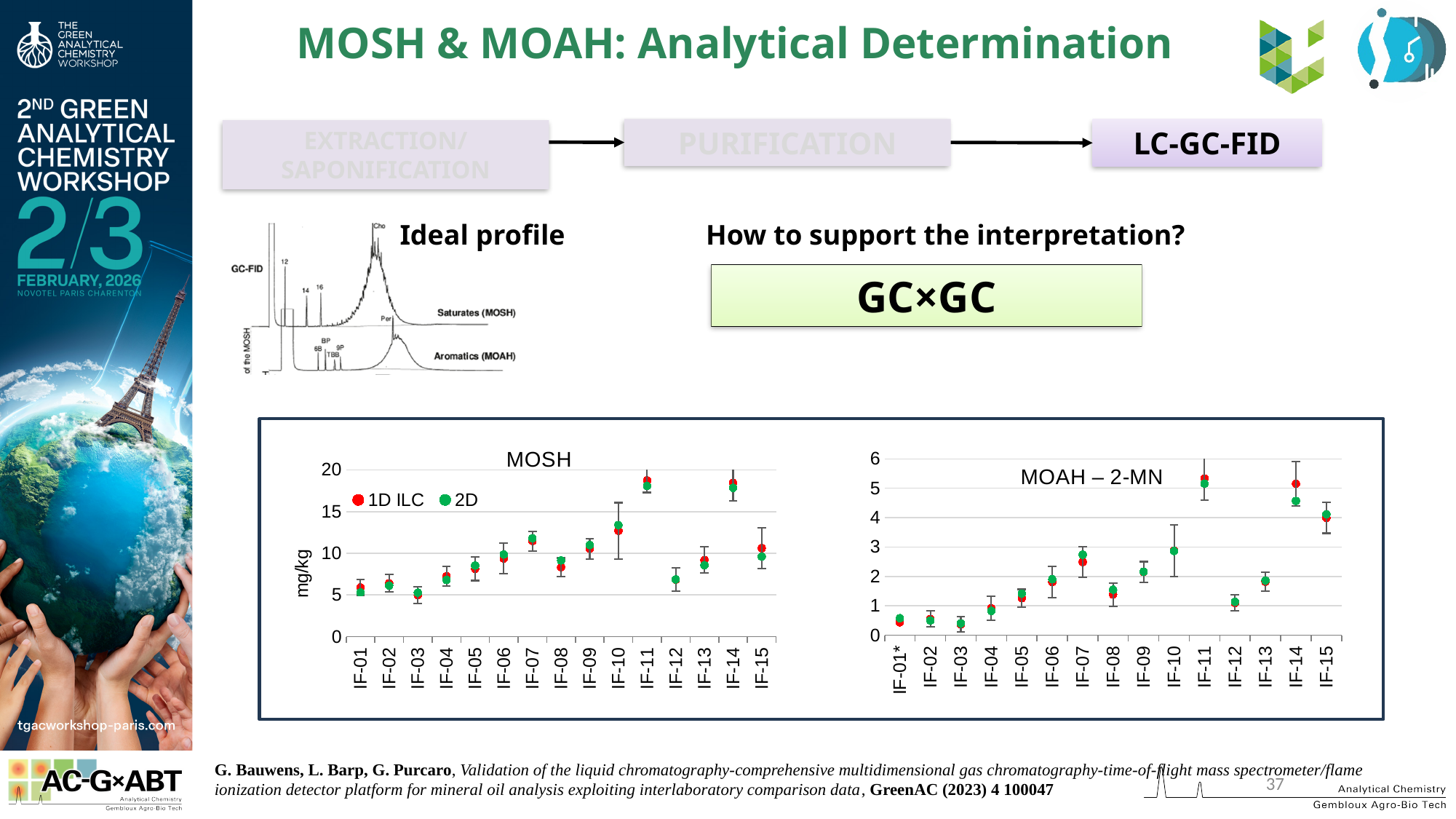
In the MOAH – 2-MN chart, is the value for IF-15 greater or less than 3? greater In the MOSH chart, is the value for IF-11 greater or less than 15? greater In the MOAH – 2-MN chart, is the value for IF-12 greater or less than 2? less What is the title of the chart on the left? MOSH In the MOSH chart, how many categories are shown on the x axis? 15 In the MOAH – 2-MN chart, which has the larger value, IF-07 or IF-08? IF-07 In the MOAH – 2-MN chart, how many categories are shown on the x axis? 15 What kind of chart is the MOSH chart? Scatter (dot) plot with error bars What is the title of the chart on the right? MOAH – 2-MN In the MOSH chart, how many series does the legend list? 2 In the MOSH chart, which has the larger value, IF-11 or IF-12? IF-11